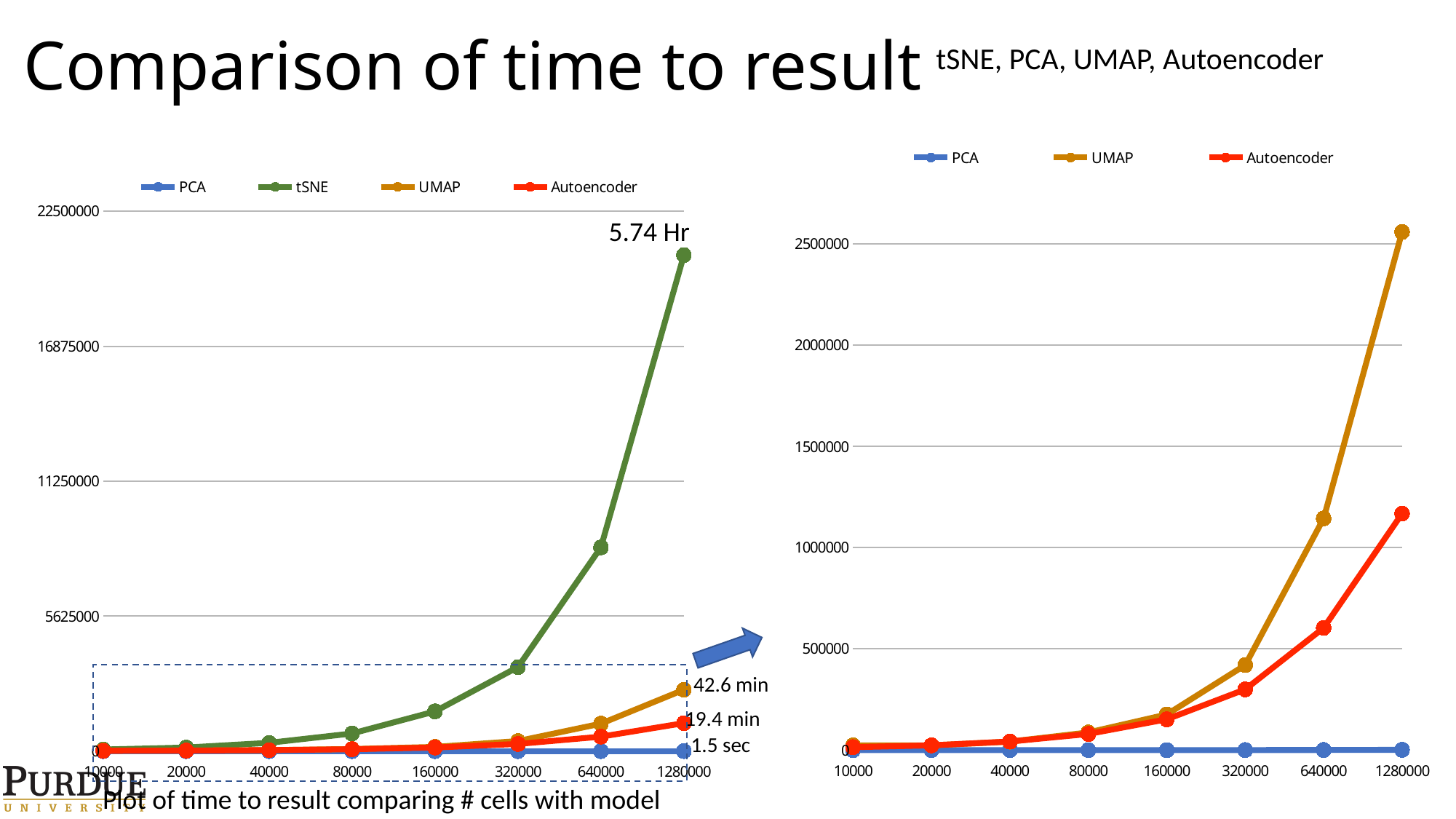
What kind of chart is the left chart on the slide? Line chart On the right chart, is the value for UMAP at 640000 cells greater or less than 1000000? greater How many x-axis categories (cell counts) are plotted on the right chart? 8 How many series does the legend of the left chart list? 4 On the right chart, which is larger at 1280000 cells: UMAP or Autoencoder? UMAP On the left chart, which series has the highest value at 1280000 cells? tSNE On the left chart, what time to result is annotated for PCA at 1280000 cells? 1.5 sec On the left chart, is the value for tSNE at 640000 cells greater or less than 5625000? greater On the left chart, what time to result is annotated for UMAP at 1280000 cells? 42.6 min On the left chart, what time to result is annotated for tSNE at 1280000 cells? 5.74 Hr On the right chart, does the UMAP series rise or fall as the number of cells increases? Rises How many series does the legend of the right chart list? 3